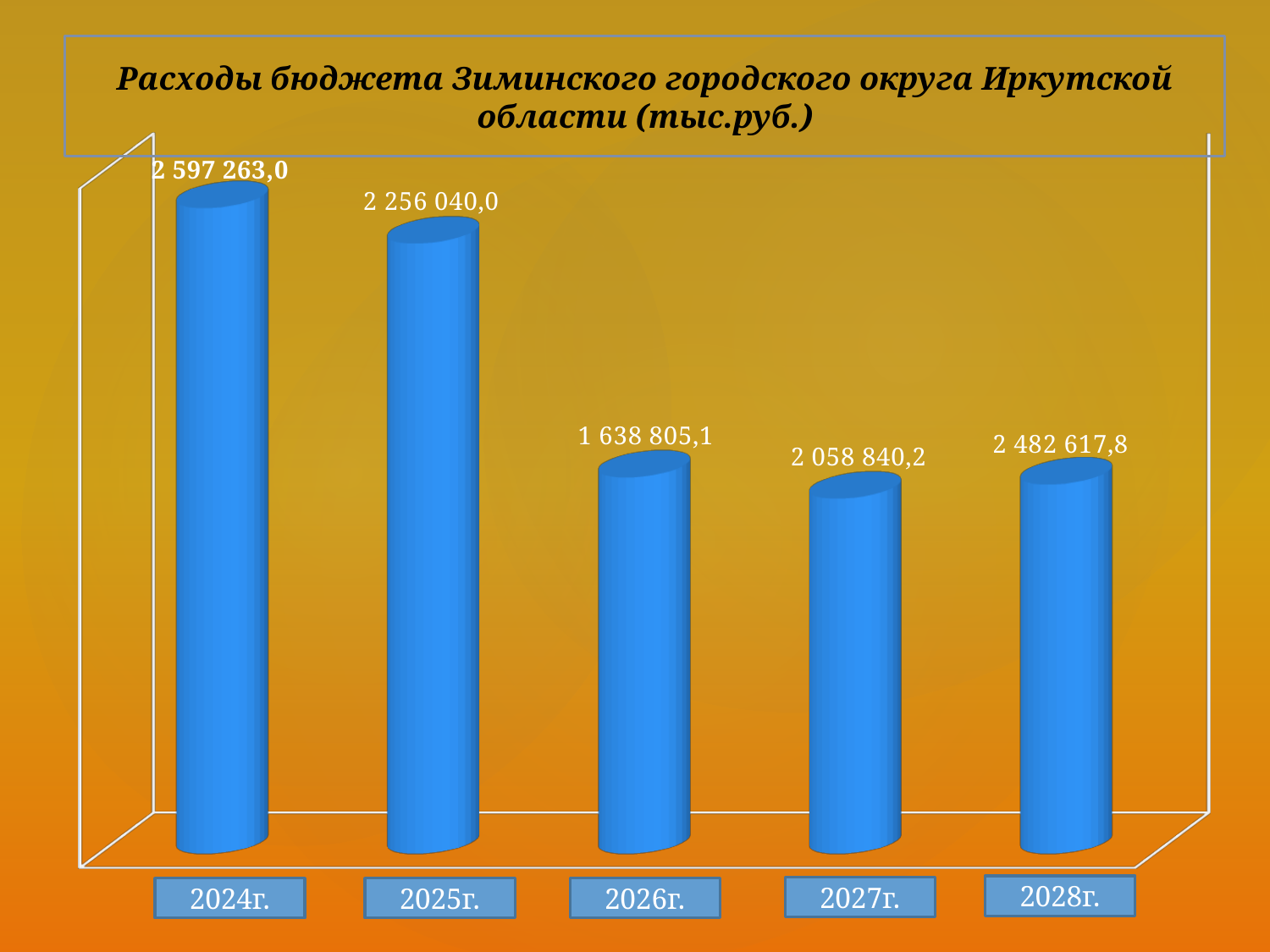
What is the budget expenditure value shown for 2024г.? 2 597 263,0 What is the value shown for 2028г.? 2 482 617,8 How many years are shown on the chart? 5 What kind of chart is shown on the slide? Bar chart What is the title of the chart? Расходы бюджета Зиминского городского округа Иркутской области (тыс.руб.) Which year has the highest budget expenditure value? 2024г. What is the difference between the values for 2024г. and 2025г.? 341 223,0 What is the difference between the values for 2024г. and 2026г.? 958 457,9 What is the value shown for 2026г.? 1 638 805,1 Which is larger, the value for 2025г. or the value for 2026г.? 2025г. What is the value shown for 2027г.? 2 058 840,2 Which year has the lowest budget expenditure value? 2026г.